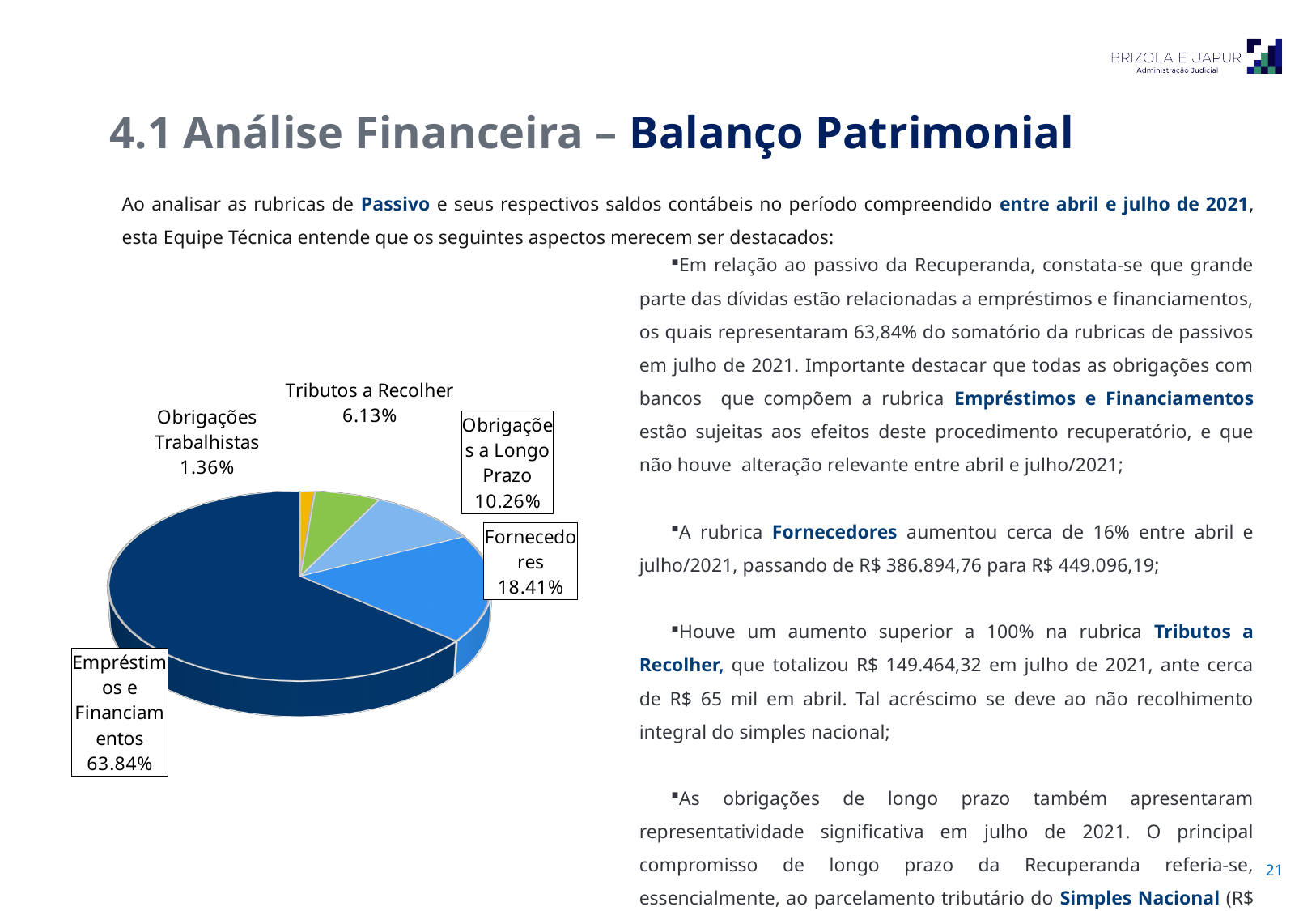
Which is larger in the pie chart, Tributos a Recolher or Obrigações a Longo Prazo? Obrigações a Longo Prazo Which category has the largest slice in the pie chart? Empréstimos e Financiamentos How many slices does the pie chart have? 5 What colour is the Empréstimos e Financiamentos slice in the pie chart? Dark blue What is the difference between the shares of Fornecedores and Obrigações a Longo Prazo? 8.15% What is the value shown for Obrigações a Longo Prazo in the pie chart? 10.26% Which category has the smallest slice in the pie chart? Obrigações Trabalhistas What share of the pie does Empréstimos e Financiamentos represent? 63.84% What is the value shown for Fornecedores in the pie chart? 18.41% What kind of chart is shown on the slide? Pie chart What is the value shown for Tributos a Recolher in the pie chart? 6.13% What is the value shown for Obrigações Trabalhistas in the pie chart? 1.36%